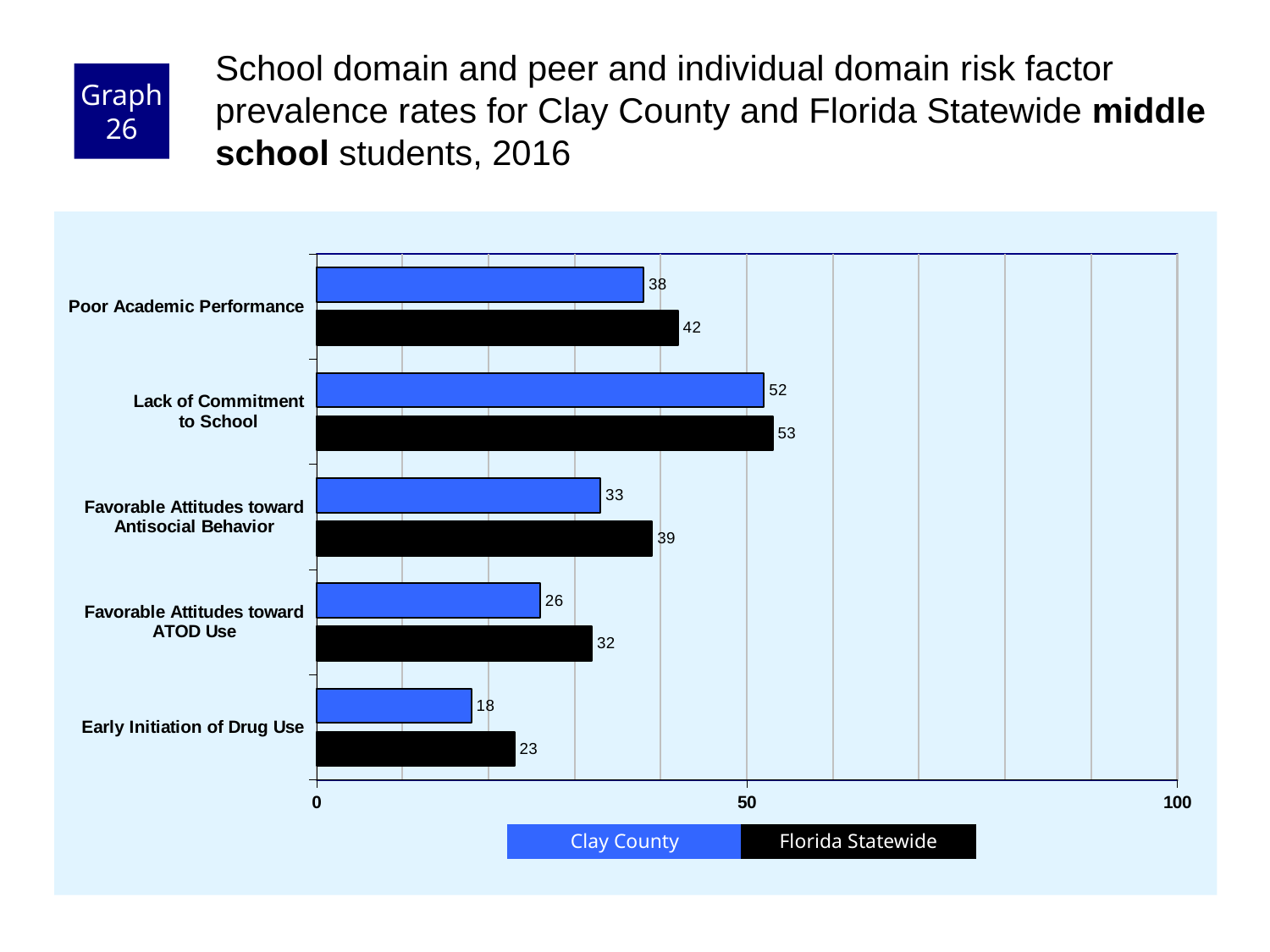
Which risk factor has the highest Clay County value? Lack of Commitment to School How many risk factors are shown on the chart? 5 How many series does the legend list? 2 Which is larger for Poor Academic Performance: the Clay County value or the Florida Statewide value? Florida Statewide What is the Clay County value for Poor Academic Performance? 38 Which colour represents Florida Statewide in the chart? black What is the difference between the Florida Statewide and Clay County values for Favorable Attitudes toward Antisocial Behavior? 6 What kind of chart is shown on the slide? bar chart Is the Clay County value for Lack of Commitment to School greater or less than 50? greater What is the Florida Statewide value for Favorable Attitudes toward ATOD Use? 32 Which risk factor has the lowest Florida Statewide value? Early Initiation of Drug Use What is the Florida Statewide value for Early Initiation of Drug Use? 23